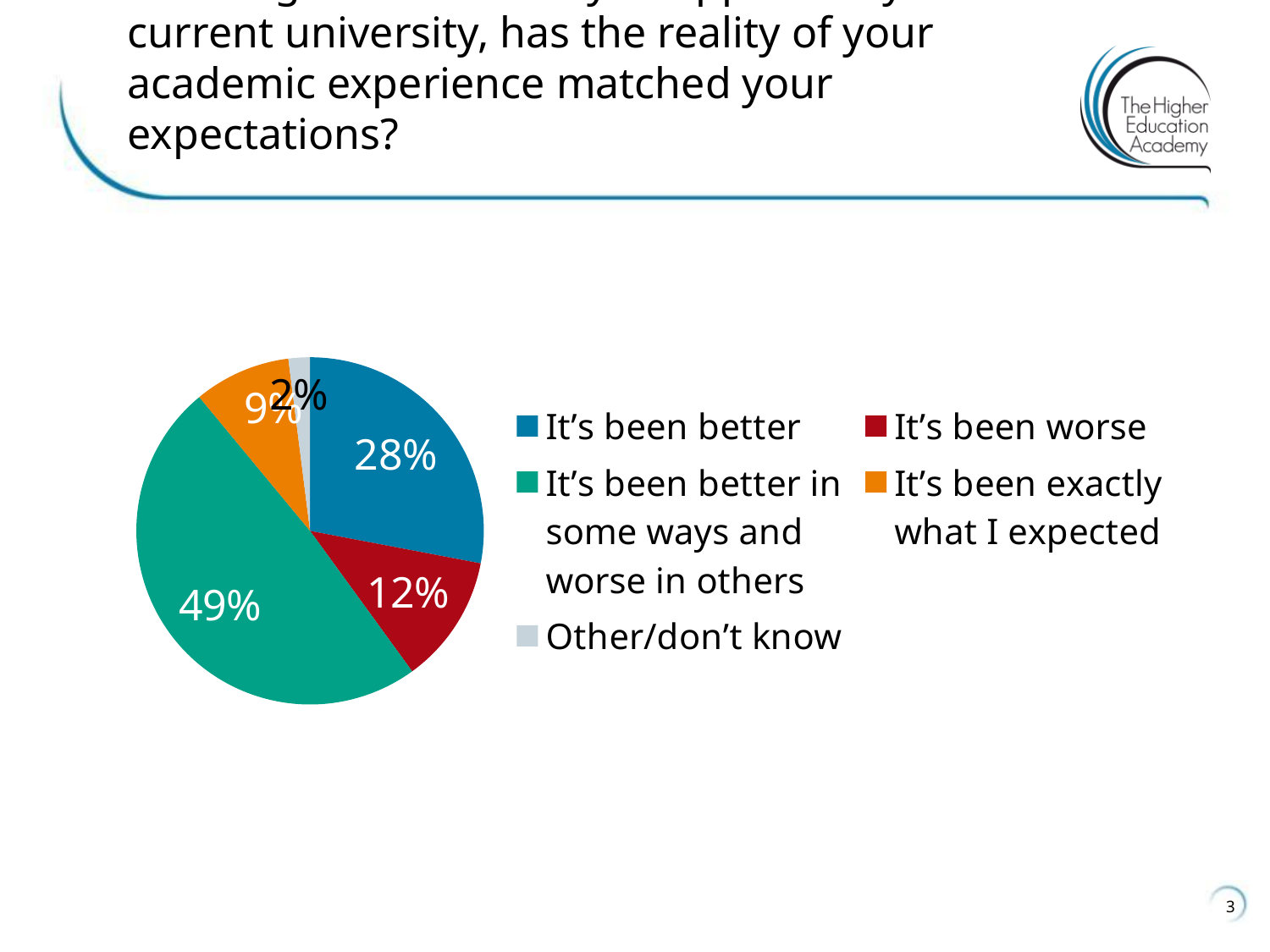
What percentage of respondents said it's been better in some ways and worse in others? 49% What is the difference in percentage points between 'It's been better' and 'It's been worse'? 16 What kind of chart is shown on the slide? Pie chart How many slices does the pie chart have? 5 Which response has the smallest share of the pie? Other/don't know What percentage of respondents said it's been exactly what I expected? 9% What percentage of respondents answered Other/don't know? 2% Which is larger: the share for 'It's been better' or the share for 'It's been exactly what I expected'? It's been better What colour is the slice for 'It's been worse'? Red What percentage of respondents said it's been better? 28% What percentage of respondents said it's been worse? 12% Which response has the largest share of the pie? It's been better in some ways and worse in others